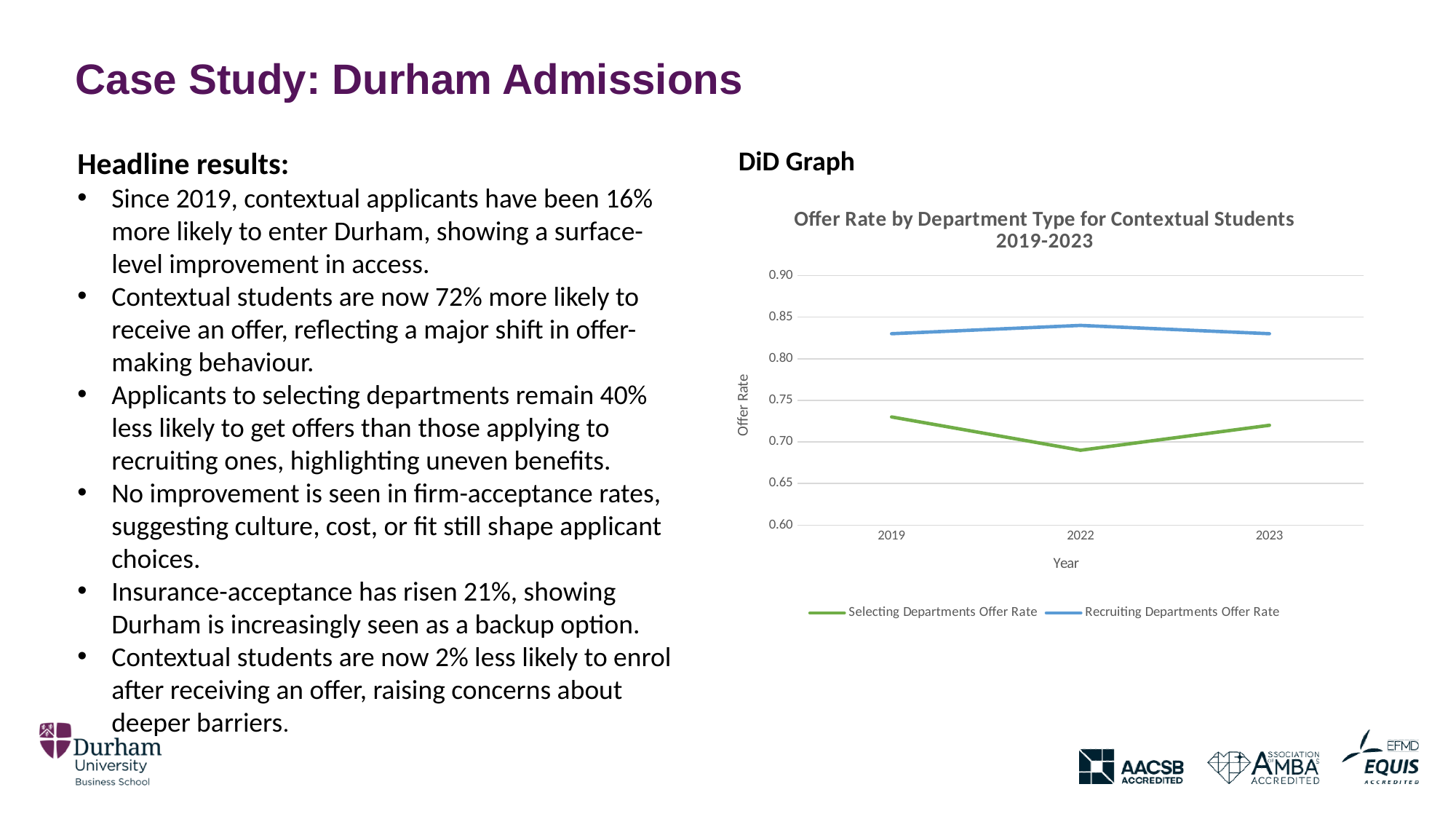
In which year is the Selecting Departments Offer Rate lowest? 2022 Which series is drawn in green in the chart? Selecting Departments Offer Rate In 2019, which is larger: the Recruiting Departments Offer Rate or the Selecting Departments Offer Rate? Recruiting Departments Offer Rate How many years are plotted along the x axis of the chart? 3 Is the Recruiting Departments Offer Rate for 2019 greater or less than 0.80? greater Is the Selecting Departments Offer Rate for 2023 greater or less than 0.75? less Is the Selecting Departments Offer Rate for 2019 greater or less than 0.70? greater Between 2019 and 2022, does the Selecting Departments Offer Rate rise or fall? fall Between 2022 and 2023, does the Selecting Departments Offer Rate rise or fall? rise What kind of chart is shown on the slide? line chart What is the title of the chart? Offer Rate by Department Type for Contextual Students 2019-2023 How many series does the chart legend list? 2